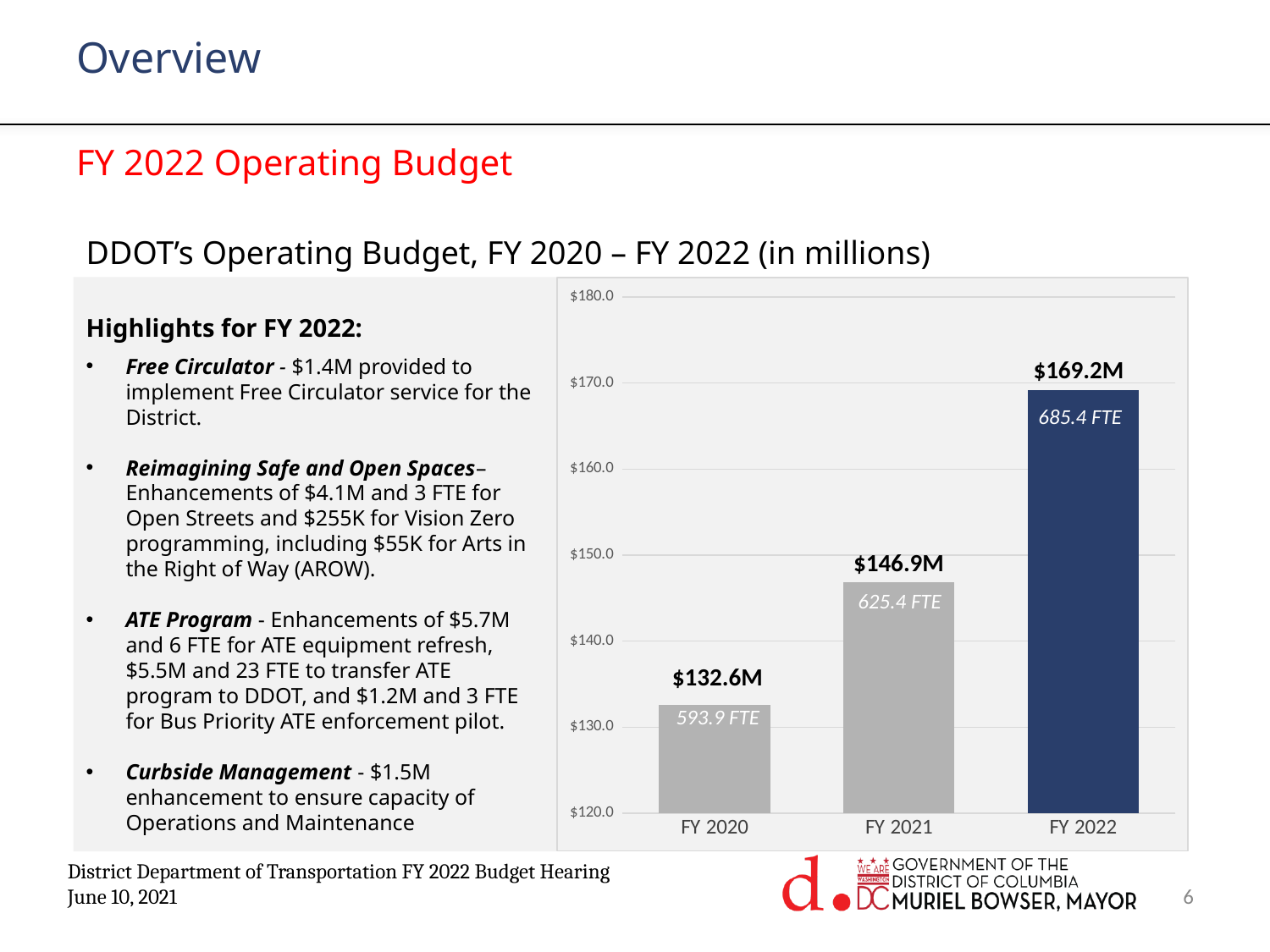
What is DDOT's operating budget for FY 2020 according to the chart? $132.6M What is the difference between the FY 2022 and FY 2021 operating budgets? $22.3M What is DDOT's operating budget for FY 2022 according to the chart? $169.2M Which is larger, the FY 2021 operating budget or the FY 2020 operating budget? FY 2021 Does DDOT's operating budget rise or fall from FY 2020 to FY 2022? Rise Is the FY 2021 operating budget greater or less than $150.0? less Which fiscal year has the lowest operating budget in the chart? FY 2020 What is the difference between the FY 2021 and FY 2020 operating budgets? $14.3M How many fiscal years are plotted in the chart? 3 How many FTE are shown for FY 2021 in the chart? 625.4 FTE What kind of chart is used to show DDOT's operating budget? Bar chart Which fiscal year has the highest operating budget in the chart? FY 2022